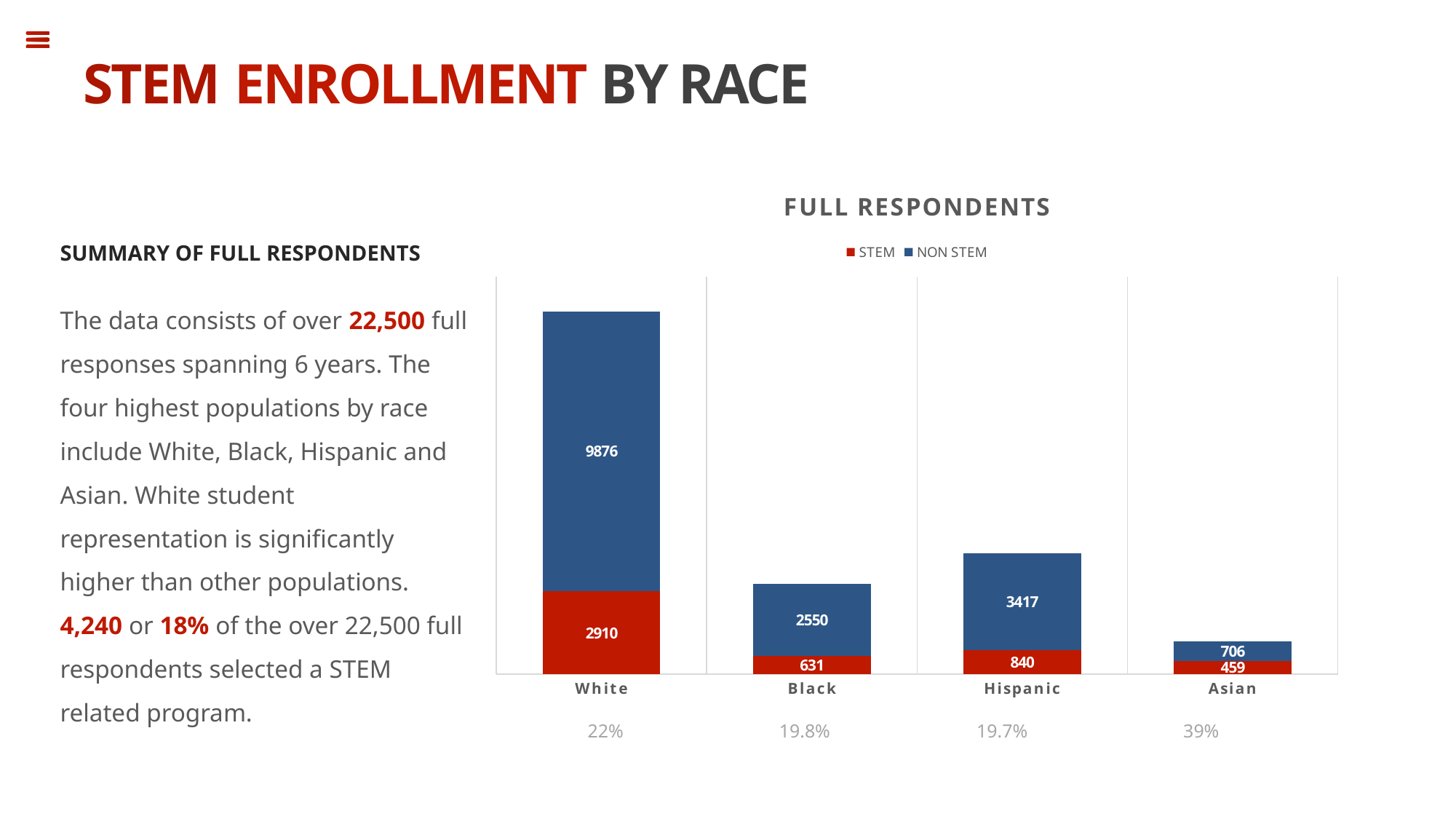
What kind of chart is shown? Stacked bar chart Which is larger, the STEM value for Black or the STEM value for Hispanic? Hispanic What is the STEM value for White? 2910 What is the NON STEM value for Hispanic? 3417 What is the total of the stacked bar for White? 12786 What is the difference between the NON STEM values for Hispanic and Black? 867 What is the STEM value for Asian? 459 How many series does the legend list? 2 Which category has the highest NON STEM value? White Which category has the lowest STEM value? Asian How many categories are shown on the x axis? 4 What is the total of the stacked bar for Asian? 1165